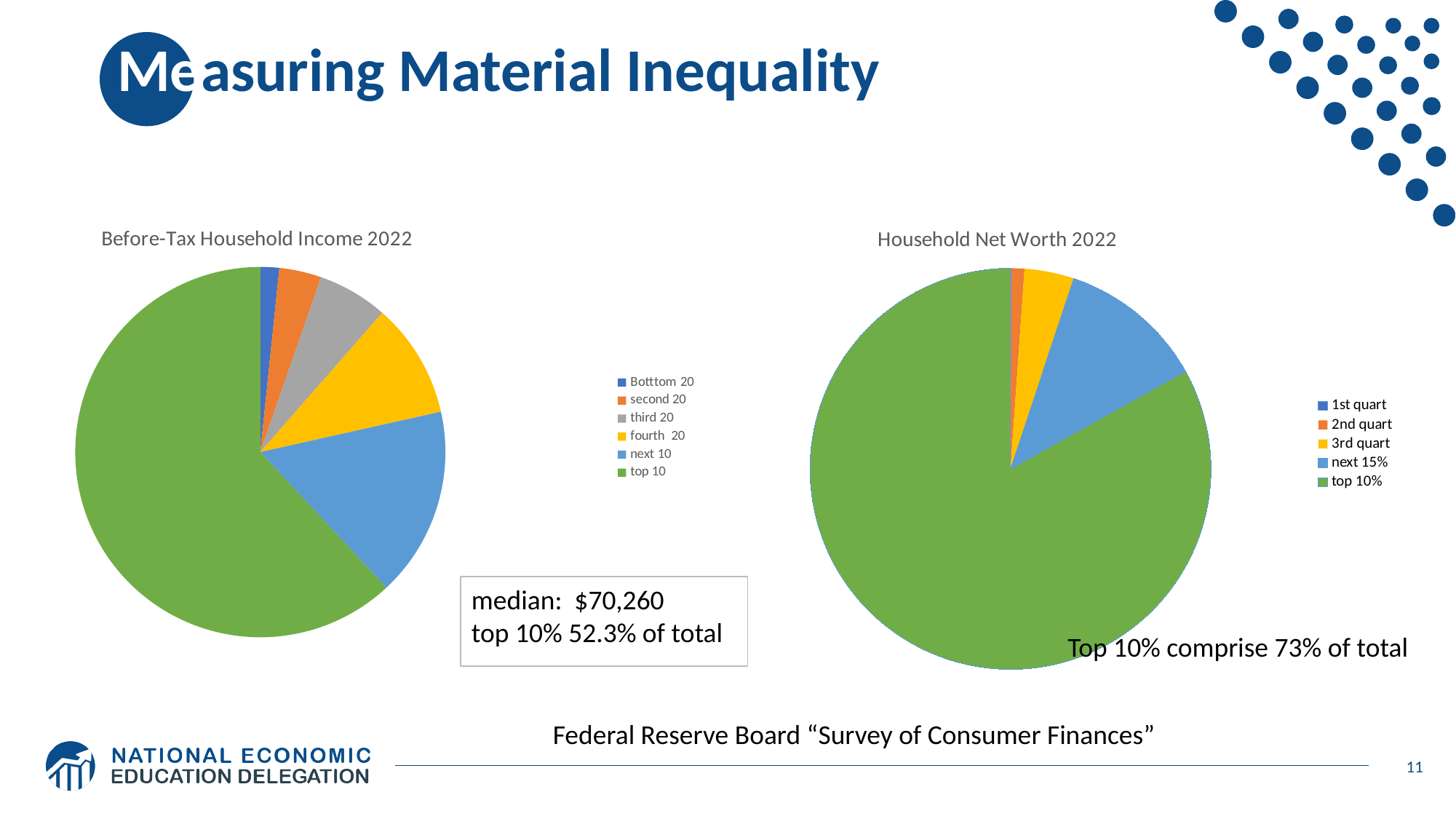
By how many percentage points does the top 10% share in the Household Net Worth 2022 chart exceed the top 10 share in the Before-Tax Household Income 2022 chart? 20.7 percentage points In the Household Net Worth 2022 chart, what share of the total does the top 10% hold? 73% In the Before-Tax Household Income 2022 chart, which group has the largest slice? top 10 In the Household Net Worth 2022 chart, which slice is larger: 3rd quart or next 15%? next 15% In the Before-Tax Household Income 2022 chart, which slice is larger: fourth 20 or next 10? next 10 In the Before-Tax Household Income 2022 chart, which group has the smallest slice? Botttom 20 In the Before-Tax Household Income 2022 chart, what share of the total does the top 10 hold? 52.3% What median value is shown in the text box next to the Before-Tax Household Income 2022 chart? $70,260 How many series does the legend of the Household Net Worth 2022 chart list? 5 In the Household Net Worth 2022 chart, which group has the largest slice? top 10% What kind of chart is the Before-Tax Household Income 2022 chart? pie chart How many series does the legend of the Before-Tax Household Income 2022 chart list? 6